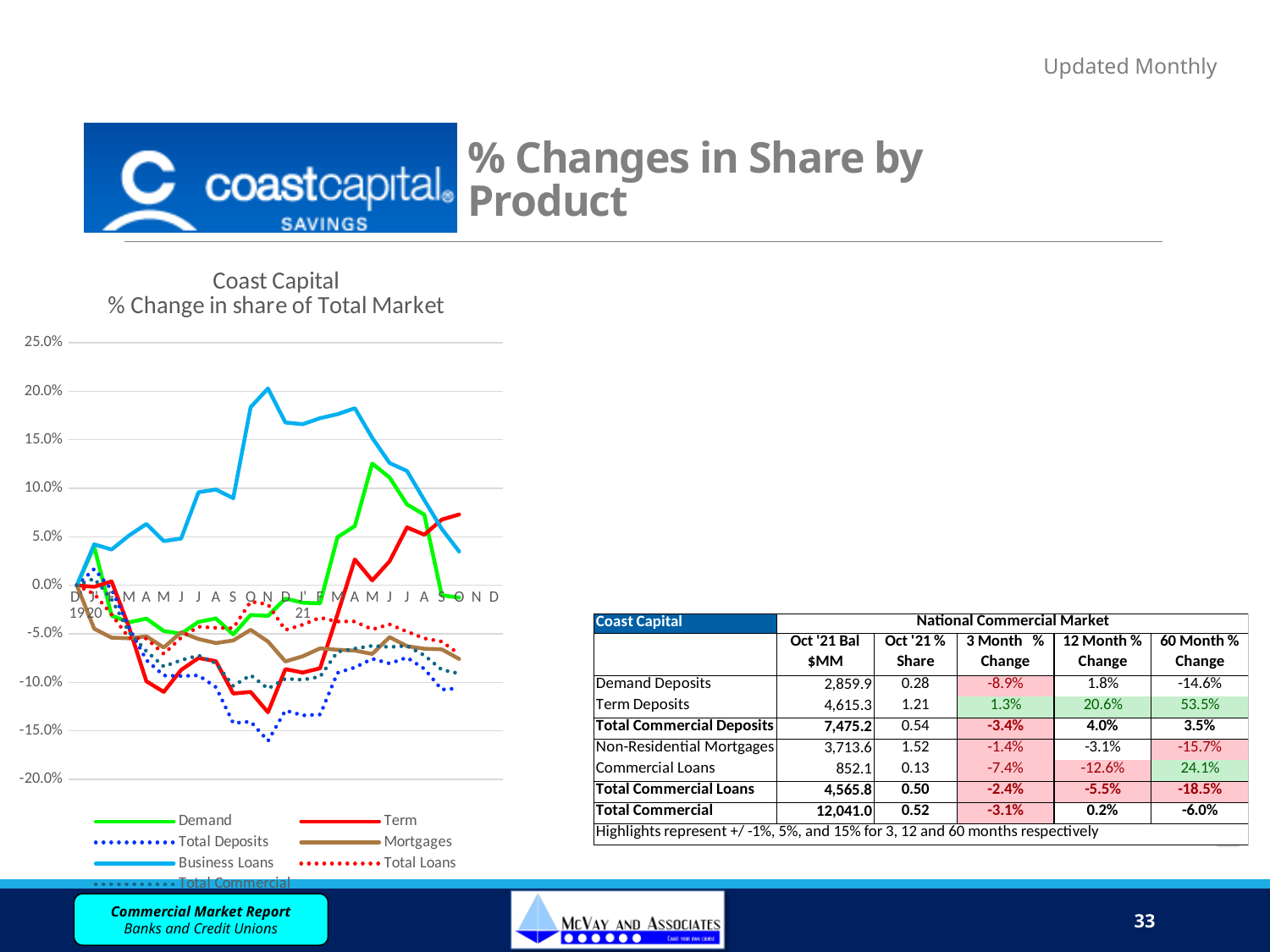
Which series reaches the highest value on the chart? Business Loans Is the lowest value reached by Total Deposits greater or less than -10.0%? less What is the highest value shown on the chart's vertical axis? 25.0% Is the highest value reached by Demand greater or less than 10.0%? greater How many series does the chart legend list? 7 Is the highest value reached by Business Loans greater or less than 15.0%? greater Which series reaches a higher peak value, Business Loans or Demand? Business Loans What kind of chart is shown on the slide? line chart Which series reaches the lowest value on the chart? Total Deposits What is the title of the chart? Coast Capital % Change in share of Total Market